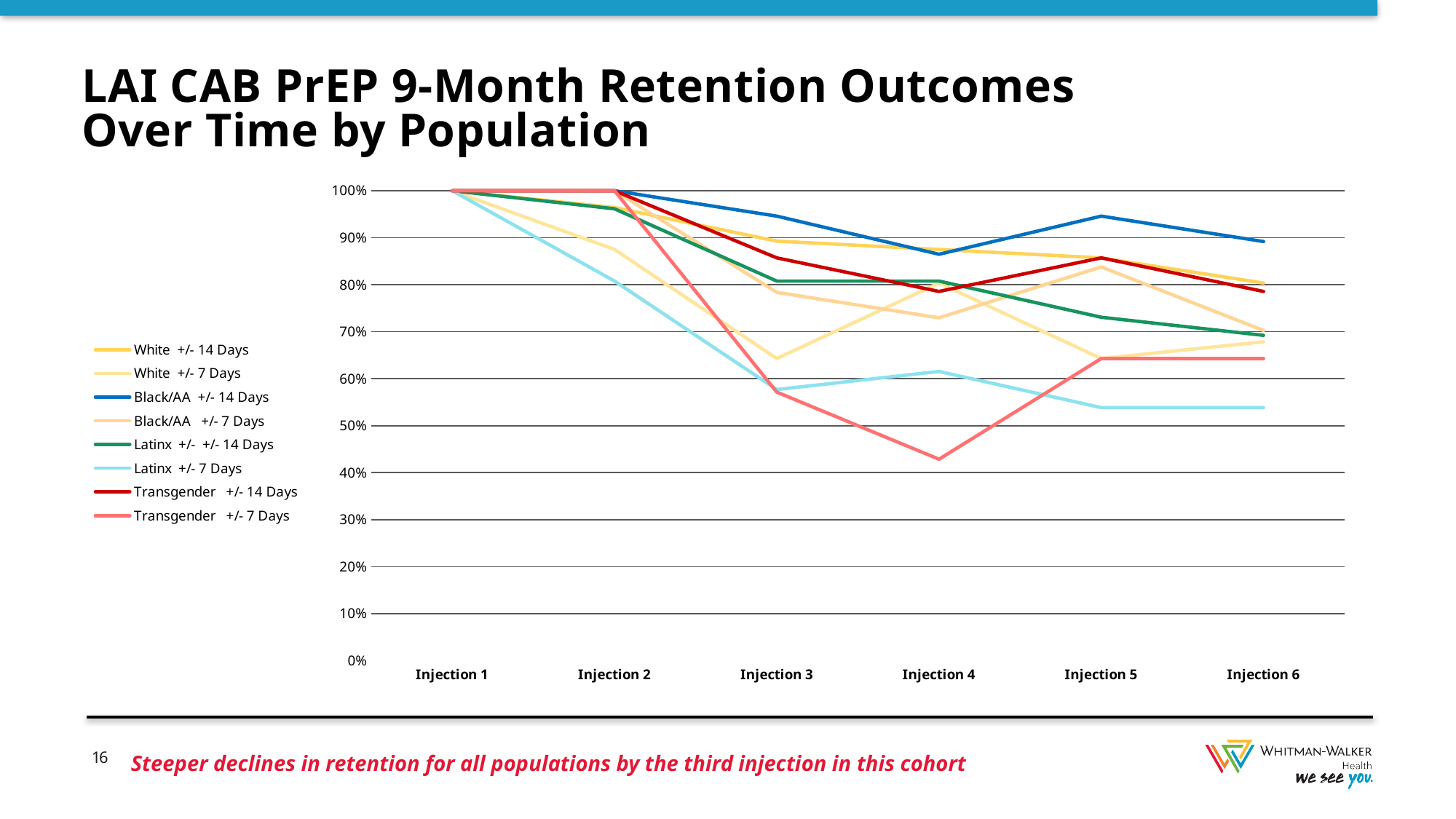
Is the value for Latinx +/- 7 Days at Injection 6 greater or less than 60%? less Is the value for Transgender +/- 7 Days at Injection 4 greater or less than 50%? less What kind of chart is shown on the slide? line chart Which series has the highest value at Injection 6? Black/AA +/- 14 Days Which series has the lowest value at Injection 4? Transgender +/- 7 Days How many injection time points are shown on the x axis? 6 At Injection 3, which is higher: Black/AA +/- 14 Days or Transgender +/- 7 Days? Black/AA +/- 14 Days How many series does the legend list? 8 Does the Latinx +/- 7 Days line rise or fall overall from Injection 1 to Injection 6? fall Is the value for Black/AA +/- 14 Days at Injection 5 greater or less than 90%? greater What is the retention value for Black/AA +/- 14 Days at Injection 1? 100% What is the retention value for Transgender +/- 7 Days at Injection 2? 100%